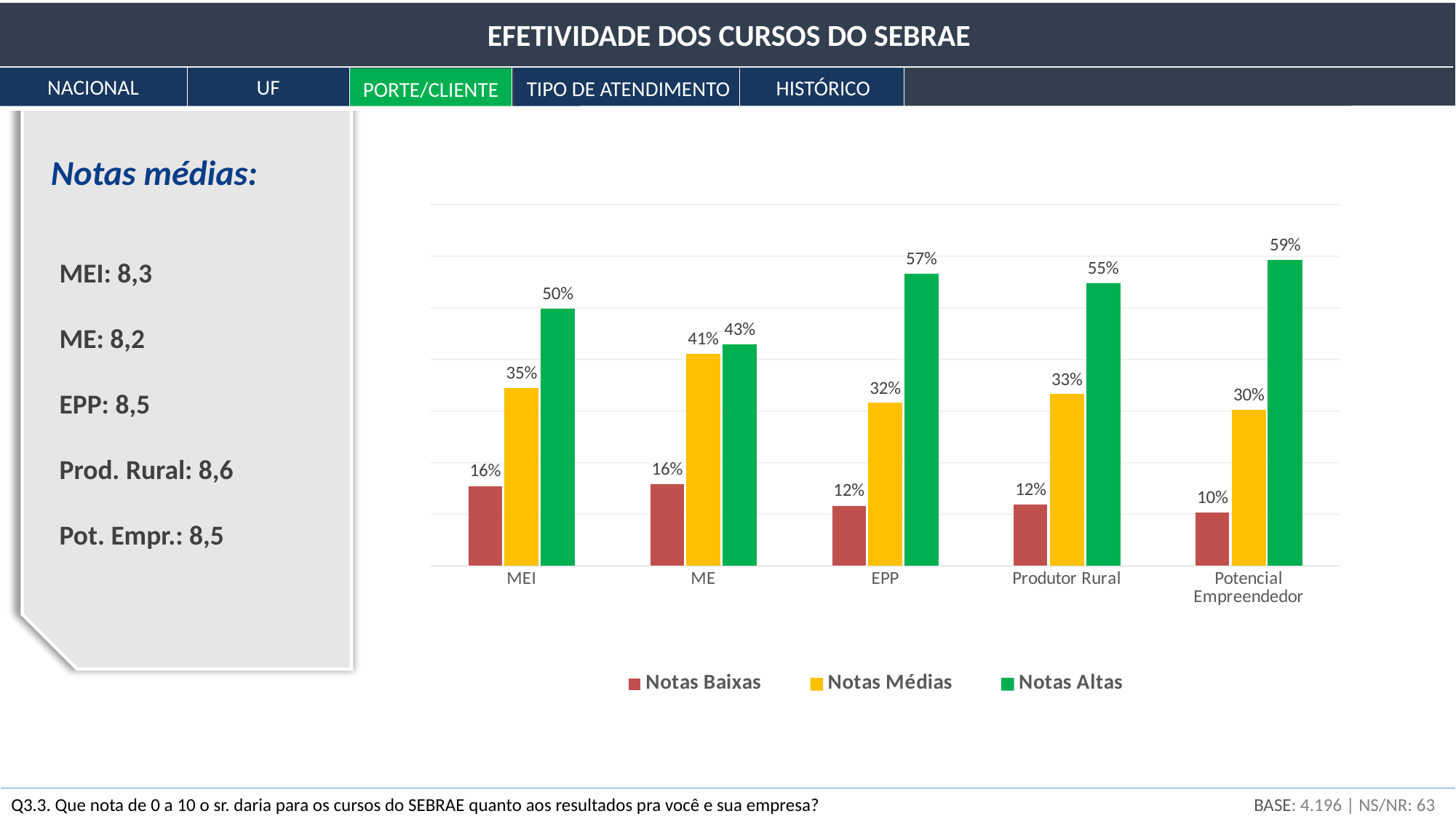
What is the value of Notas Médias for ME? 41% How many categories are shown on the x axis? 5 How many series does the legend list? 3 What colour represents Notas Altas in the legend? Green Which is larger for Produtor Rural: Notas Médias or Notas Altas? Notas Altas What is the difference between Notas Altas and Notas Médias for MEI? 15% What kind of chart is shown? Bar chart Which category has the highest Notas Altas value? Potencial Empreendedor Which category has the lowest Notas Médias value? Potencial Empreendedor Which category has the lowest Notas Baixas value? Potencial Empreendedor What is the value of Notas Baixas for Potencial Empreendedor? 10% What is the value of Notas Altas for EPP? 57%